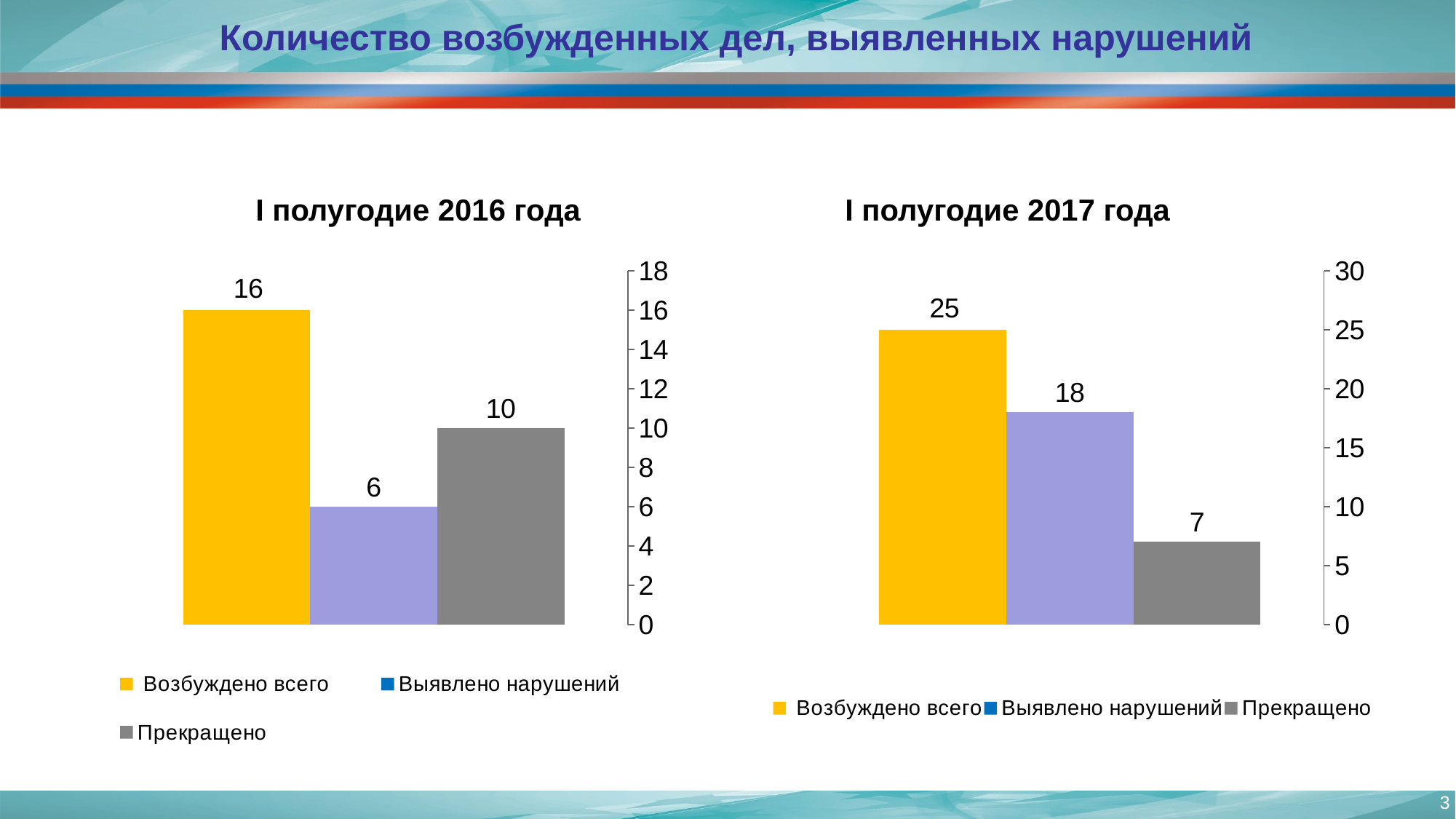
How many series does the legend of the chart titled "I полугодие 2017 года" list? 3 In the chart titled "I полугодие 2017 года", what is the difference between "Возбуждено всего" and "Выявлено нарушений"? 7 In the chart titled "I полугодие 2017 года", what is the value for "Прекращено"? 7 In the chart titled "I полугодие 2016 года", which series has the lowest value? Выявлено нарушений What type of chart is the chart titled "I полугодие 2016 года"? Bar chart In the chart titled "I полугодие 2016 года", what is the value for "Возбуждено всего"? 16 In the chart titled "I полугодие 2017 года", what is the value for "Выявлено нарушений"? 18 What is the title of the slide? Количество возбужденных дел, выявленных нарушений In the chart titled "I полугодие 2016 года", what is the value for "Выявлено нарушений"? 6 In the chart titled "I полугодие 2017 года", which series has the highest value? Возбуждено всего In the chart titled "I полугодие 2016 года", what is the difference between "Возбуждено всего" and "Прекращено"? 6 In the chart titled "I полугодие 2016 года", which is larger: "Прекращено" or "Выявлено нарушений"? Прекращено